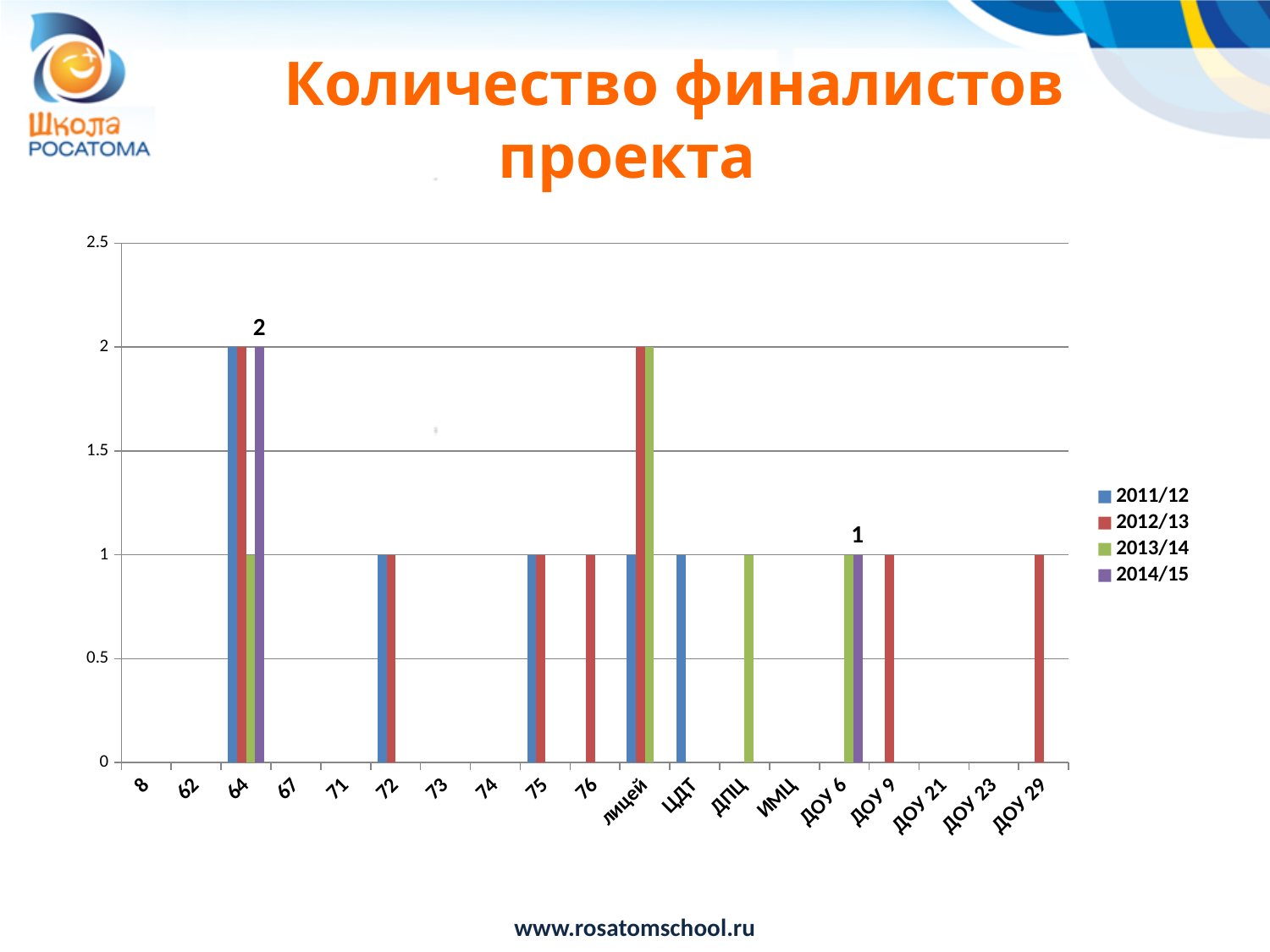
How many categories are shown on the x axis? 19 What is the value for 2013/14 for category 64? 1 What is the title of the chart? Количество финалистов проекта What is the value for 2012/13 for лицей? 2 What kind of chart is shown on the slide? bar chart What is the value for 2014/15 for category 64? 2 Which category has the highest value for the 2014/15 series? 64 Which is larger for лицей: the 2011/12 value or the 2013/14 value? 2013/14 Which series is shown in purple in the legend? 2014/15 How many series does the legend list? 4 What is the difference between the 2014/15 value for 64 and the 2014/15 value for ДОУ 6? 1 What is the value for 2014/15 for ДОУ 6? 1